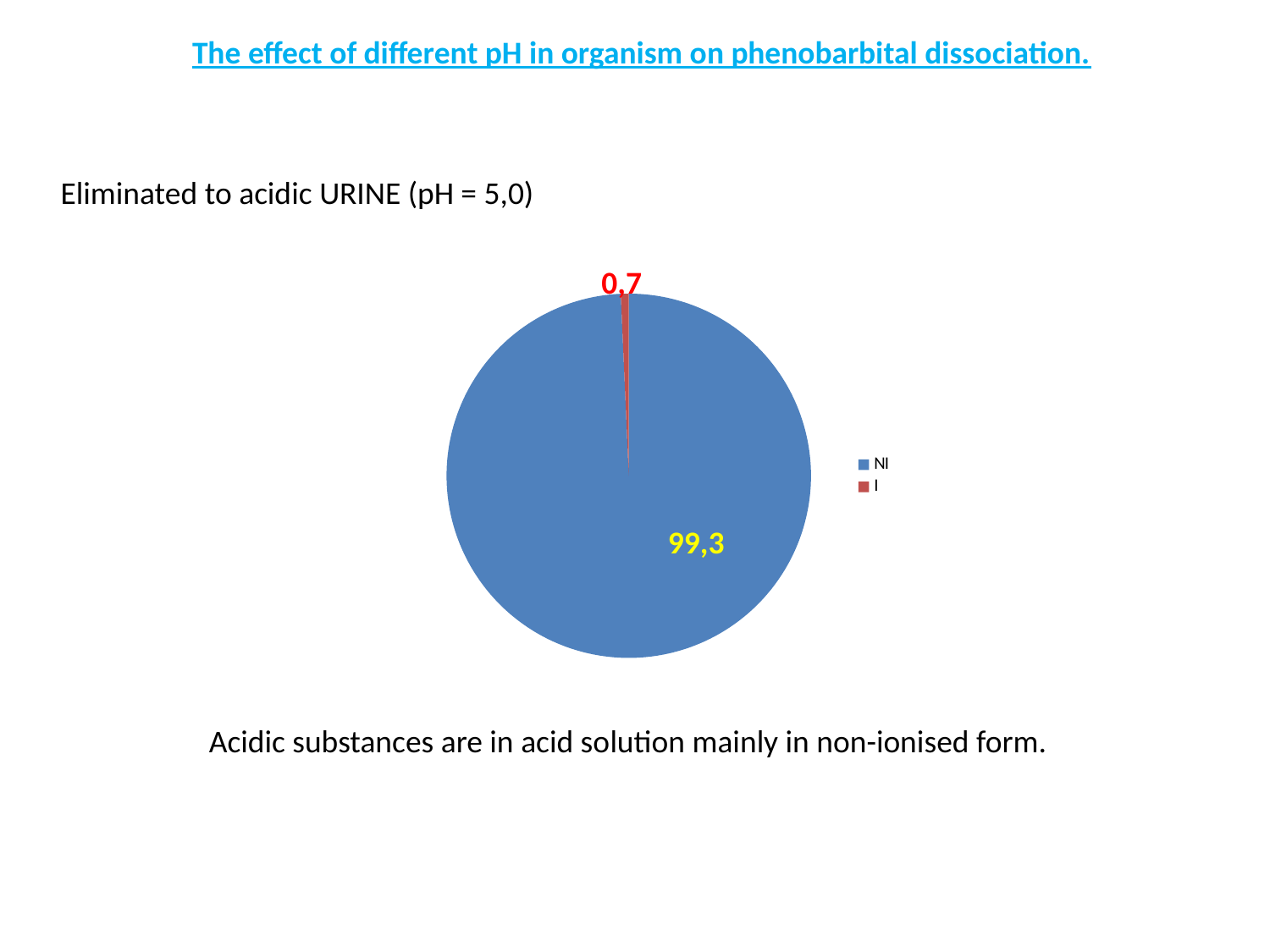
What is the value for NI in the pie chart? 99,3 How many entries does the legend list? 2 Which category has the largest slice in the pie chart? NI What is the total of the two slices in the pie chart? 100 What kind of chart is shown on the slide? pie chart What is the difference between the values for NI and I? 98,6 What is the value for I in the pie chart? 0,7 What colour is the NI slice in the pie chart? blue What colour is the I slice in the pie chart? red Which category has the smallest slice in the pie chart? I How many slices does the pie chart have? 2 Which is larger, the value for NI or the value for I? NI